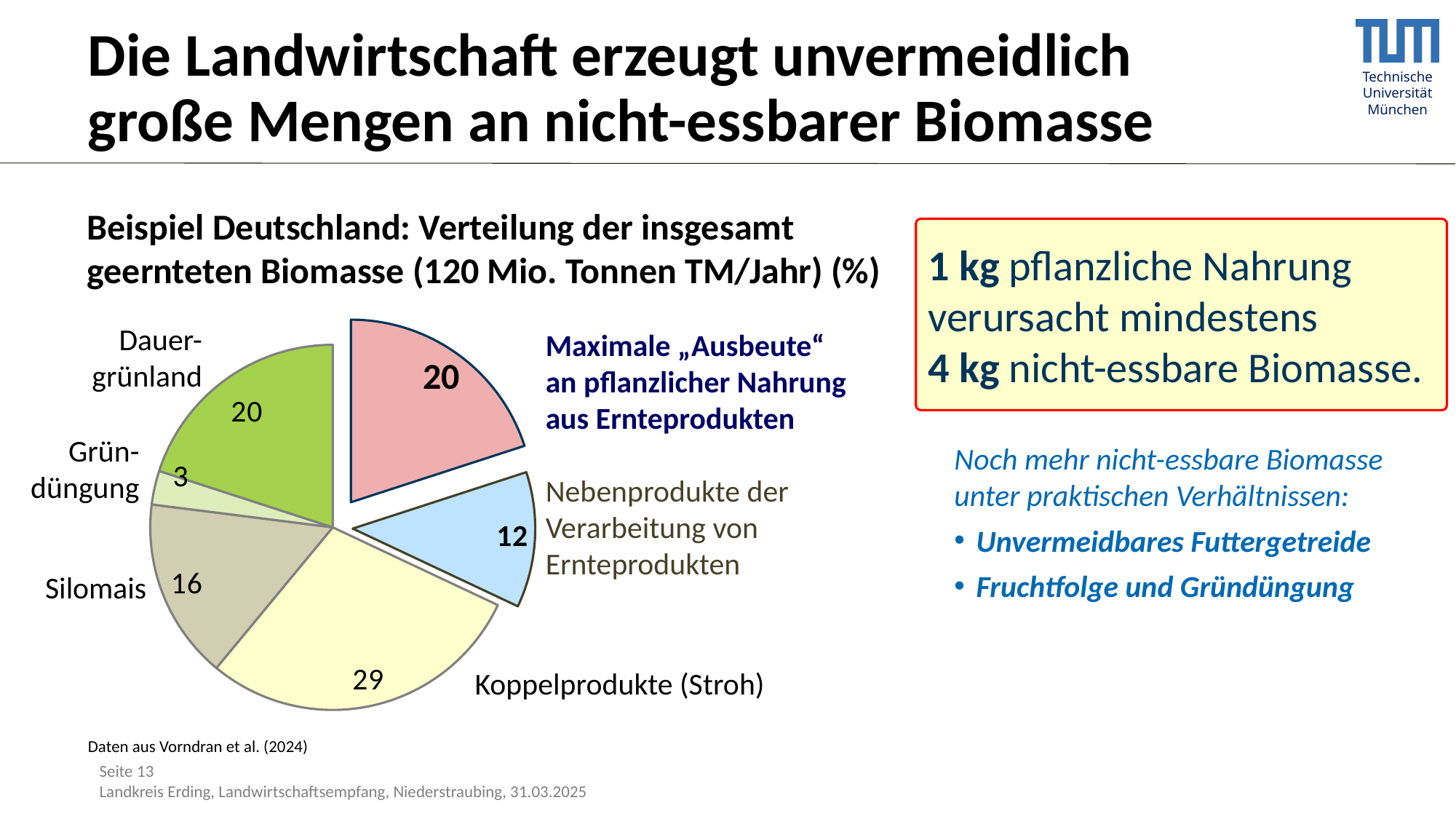
Which is larger, the value for Silomais or the value for Nebenprodukte der Verarbeitung von Ernteprodukten? Silomais What is the value for Koppelprodukte (Stroh)? 29 Which category has the largest slice of the pie? Koppelprodukte (Stroh) What is the value for Silomais? 16 What is the difference between the values for Koppelprodukte (Stroh) and Silomais? 13 What kind of chart is shown on the slide? pie chart How many slices does the pie chart have? 6 What is the value for Dauergrünland? 20 What is the value for Nebenprodukte der Verarbeitung von Ernteprodukten? 12 What is the value for Gründüngung? 3 Which category has the smallest slice of the pie? Gründüngung